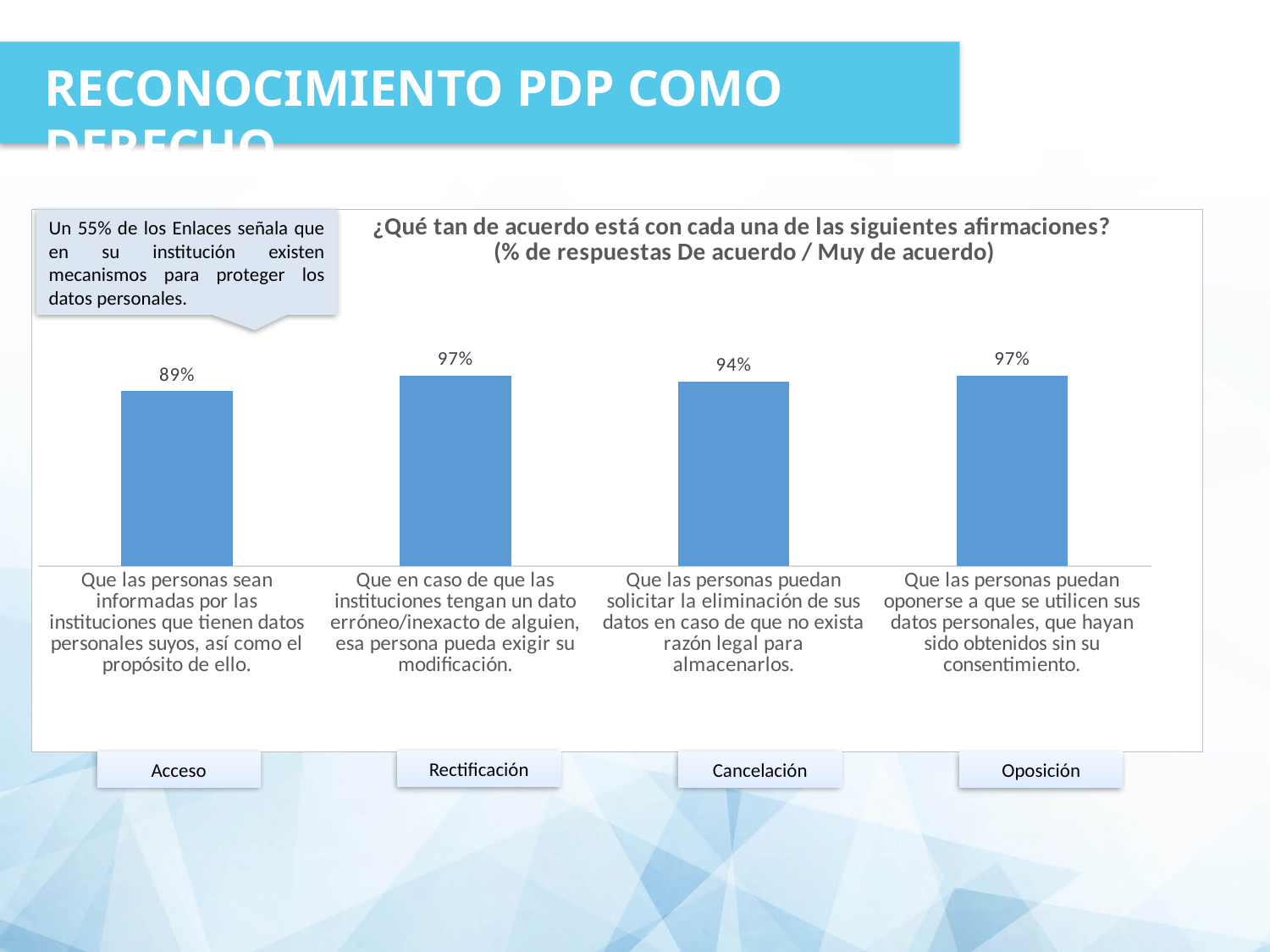
Which two categories share the same value of 97%? Rectificación and Oposición What is the title of the chart? ¿Qué tan de acuerdo está con cada una de las siguientes afirmaciones? (% de respuestas De acuerdo / Muy de acuerdo) What is the value shown for the bar 'Que las personas puedan solicitar la eliminación de sus datos en caso de que no exista razón legal para almacenarlos' (Cancelación)? 94% What is the value shown for the first bar, 'Que las personas sean informadas por las instituciones que tienen datos personales suyos, así como el propósito de ello' (Acceso)? 89% Which category has the lowest value in the chart? Que las personas sean informadas por las instituciones que tienen datos personales suyos, así como el propósito de ello (Acceso) What is the difference between the value for Rectificación (second bar) and the value for Acceso (first bar)? 8 percentage points How many bars (categories) does the chart show? 4 What is the value shown for the bar 'Que en caso de que las instituciones tengan un dato erróneo/inexacto de alguien, esa persona pueda exigir su modificación' (Rectificación)? 97% What is the value shown for the fourth bar, 'Que las personas puedan oponerse a que se utilicen sus datos personales, que hayan sido obtenidos sin su consentimiento' (Oposición)? 97% What type of chart is shown on the slide? bar chart Which is larger: the value for Cancelación (third bar) or the value for Acceso (first bar)? Cancelación (94%) What is the difference between the value for Cancelación (third bar) and the value for Acceso (first bar)? 5 percentage points